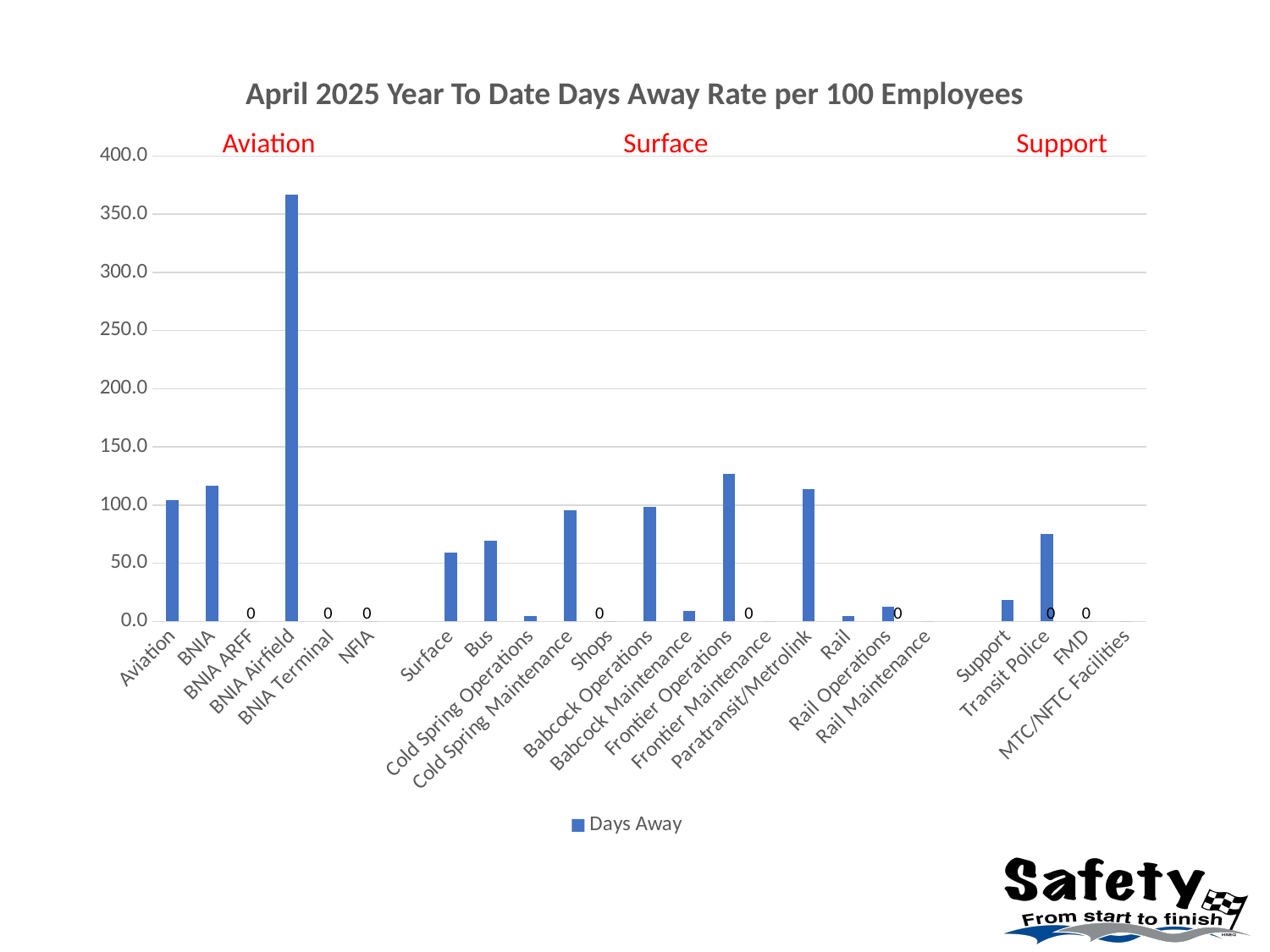
What is the title of the chart? April 2025 Year To Date Days Away Rate per 100 Employees Which category has the highest Days Away rate? BNIA Airfield What is the Days Away value shown for BNIA ARFF? 0 Which is larger, the value for Bus or the value for Surface? Bus What is the Days Away value shown for Shops? 0 Is the value for BNIA Airfield greater or less than 350? greater What kind of chart is shown on the slide? bar chart How many series does the legend list? 1 What are the three red group labels shown above the chart? Aviation, Surface, Support What is the Days Away value shown for FMD? 0 Is the value for Transit Police greater or less than 100? less Is the value for Frontier Operations greater or less than 100? greater